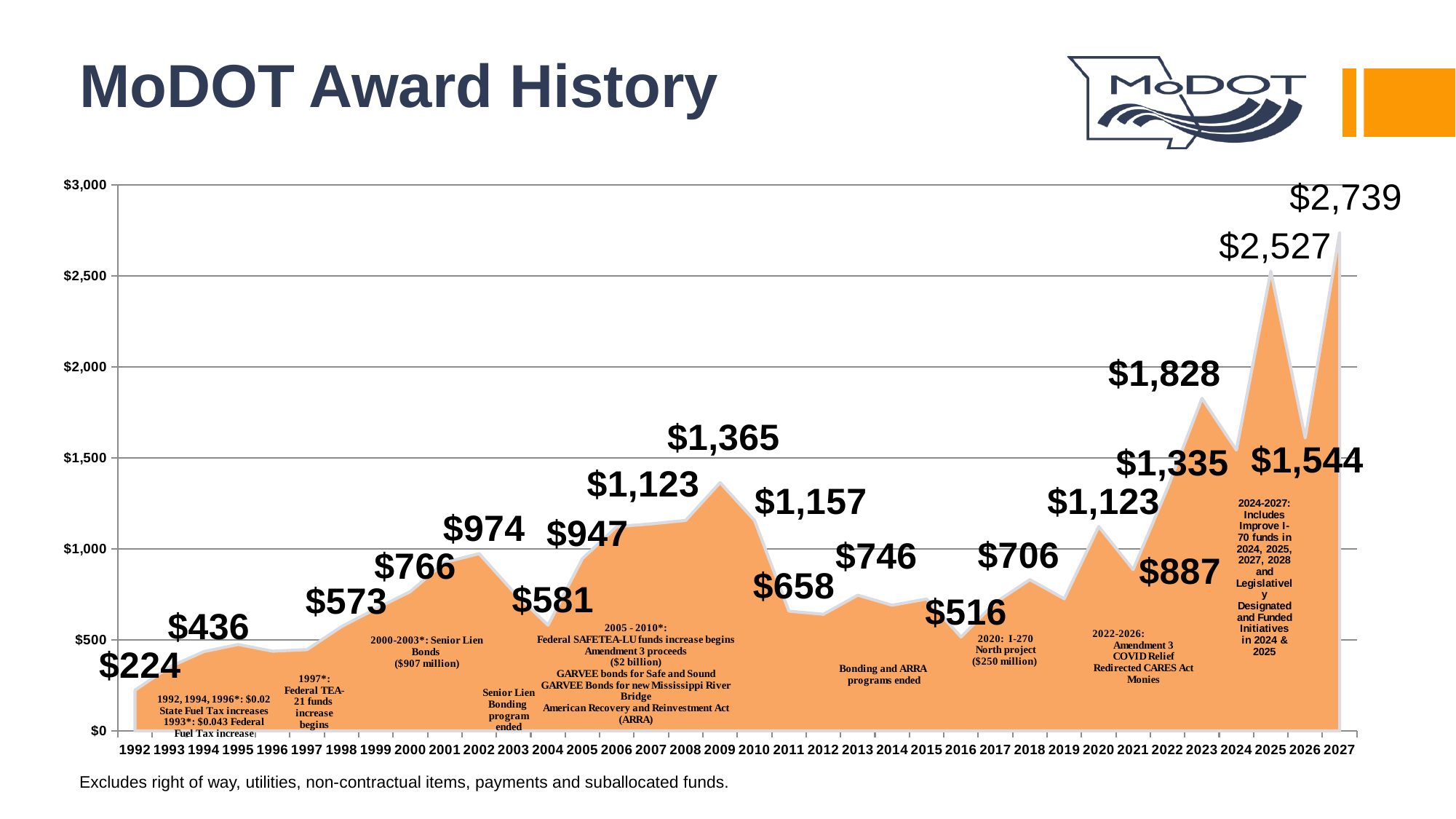
Is the value for 2026 greater or less than $2,000? less What kind of chart is shown on the slide? Area chart What is the title of the chart? MoDOT Award History What is the difference between the 2027 value and the 2025 value? $212 Which year has the lowest award value? 1992 Which year has the highest award value? 2027 Which year has the larger award value, 2009 or 2023? 2023 What is the award value shown for 2025? $2,527 What is the award value shown for 2009? $1,365 What is the award value shown for 1992? $224 What is the award value shown for 2023? $1,828 What is the award value shown for 2027? $2,739